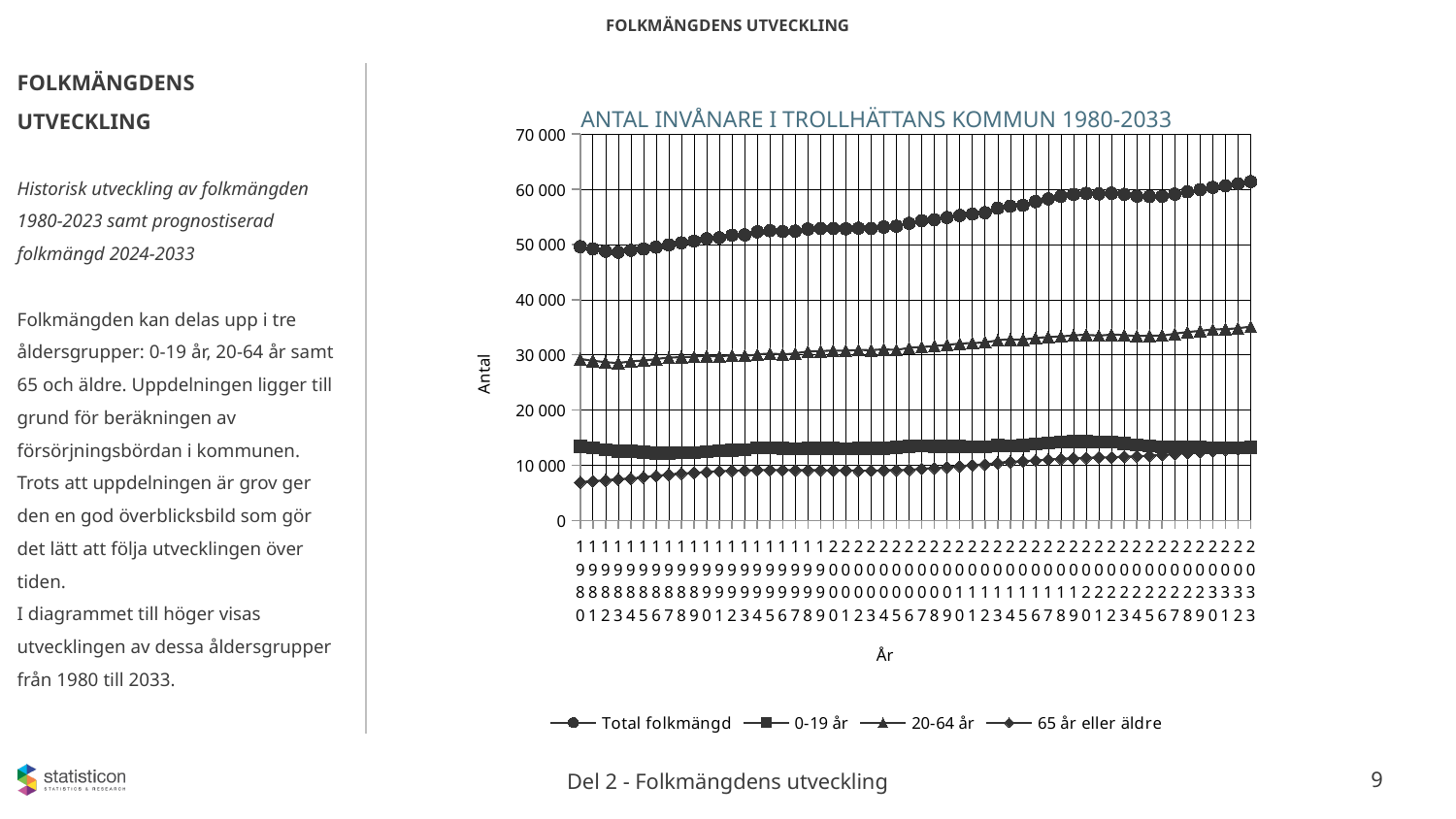
What is the label of the vertical axis? Antal How many years are plotted along the x axis? 54 Is the value for 65 år eller äldre in 1980 greater or less than 10 000? less Which series has the lowest value in 1980? 65 år eller äldre How many series does the legend list? 4 In 2033, which is larger: the value for 20-64 år or the value for 0-19 år? 20-64 år Is the value for Total folkmängd in 2033 greater or less than 60 000? greater What kind of chart is shown on the slide? Line chart Which series has the highest values across the whole period? Total folkmängd Is the value for 0-19 år in 2033 greater or less than 10 000? greater What is the title of the chart? ANTAL INVÅNARE I TROLLHÄTTANS KOMMUN 1980-2033 Does the Total folkmängd series rise or fall from 1980 to 2033? Rise